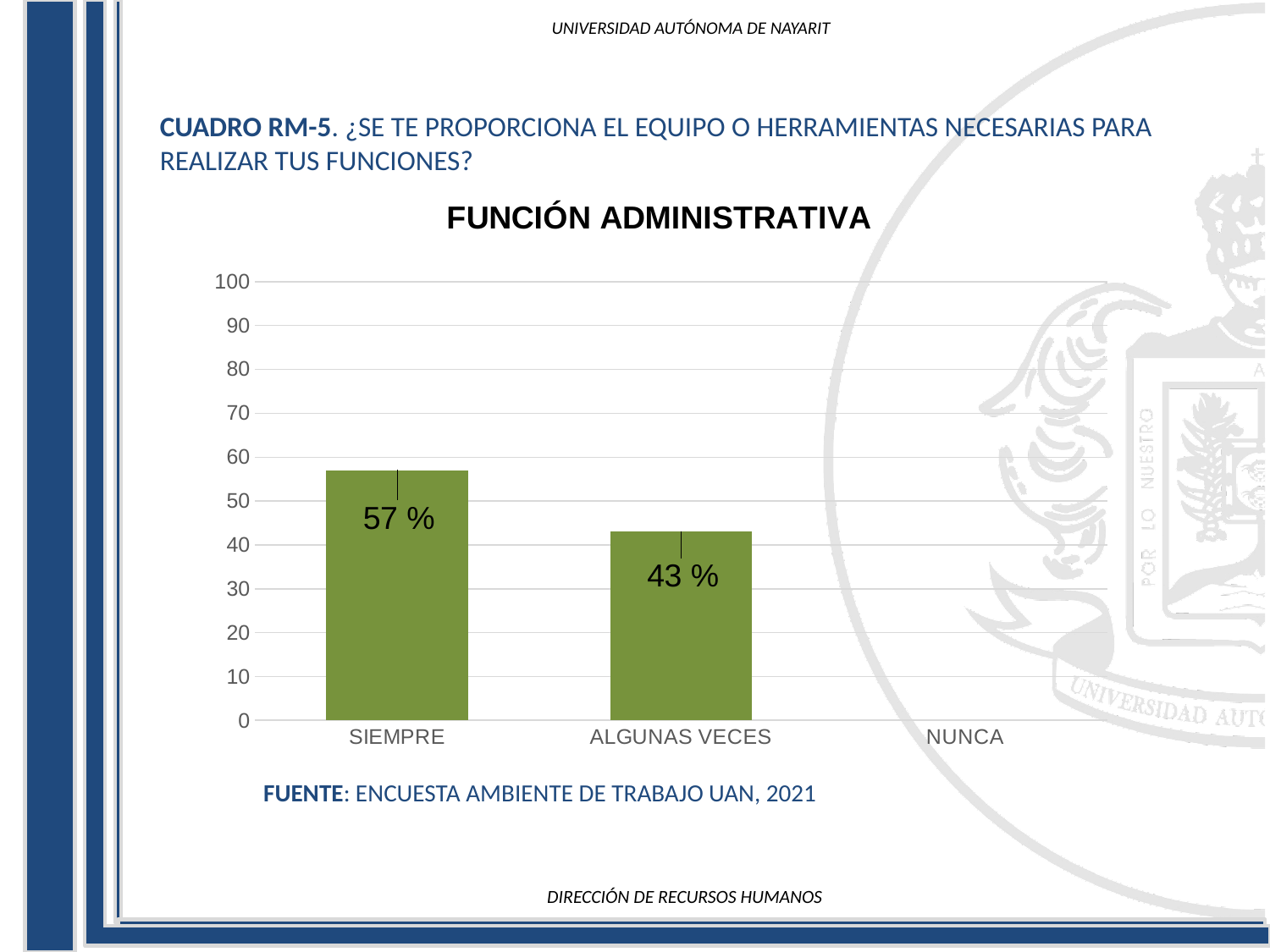
What is the title of the chart? FUNCIÓN ADMINISTRATIVA How many categories are shown on the x axis? 3 What is the value for SIEMPRE? 57 % Which category has the highest value? SIEMPRE What kind of chart is shown? bar chart What is the difference between the values for SIEMPRE and ALGUNAS VECES? 14 % Do the values rise or fall from left to right along the x axis? fall Which is larger, the value for SIEMPRE or the value for ALGUNAS VECES? SIEMPRE Is the value for SIEMPRE greater or less than 50? greater Is the value for ALGUNAS VECES greater or less than 50? less What is the value for ALGUNAS VECES? 43 %